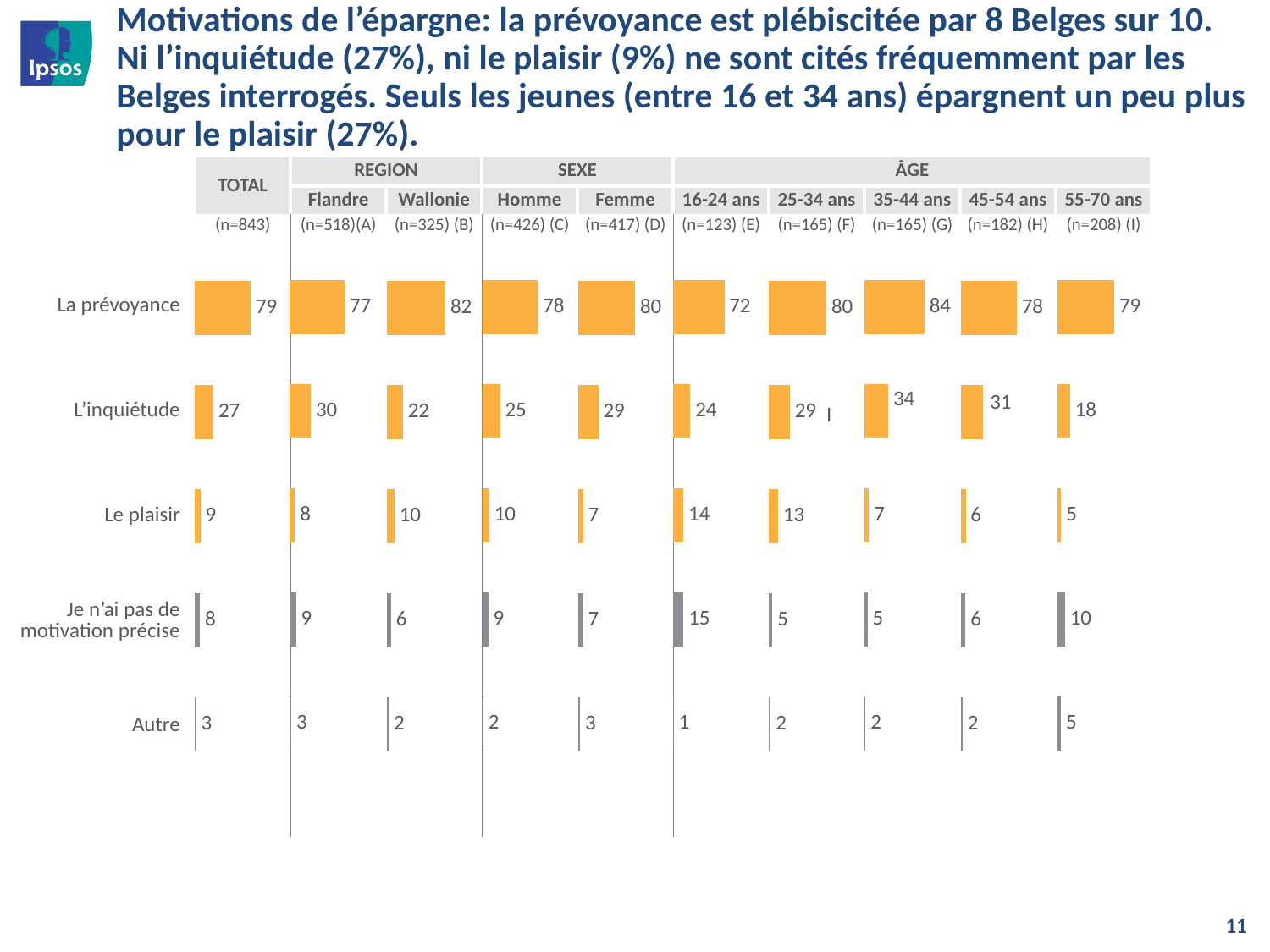
Across the age columns, which age group has the lowest value for L'inquiétude? 55-70 ans In the 55-70 ans column, what is the value for Le plaisir? 5 What is the difference between the Femme and Homme values for L'inquiétude? 4 How many motivation categories are listed down the left side of the chart? 5 Which is larger for Le plaisir: the Homme value or the Femme value? Homme Across the age columns, which age group has the highest value for La prévoyance? 35-44 ans What type of chart is used to display the values on this slide? Bar chart How many age groups are shown under the ÂGE heading? 5 In the Wallonie column, what is the value for L'inquiétude? 22 In the 16-24 ans column, what is the value for Je n'ai pas de motivation précise? 15 What is the difference between the Wallonie and Flandre values for La prévoyance? 5 In the TOTAL column, what is the value for La prévoyance? 79